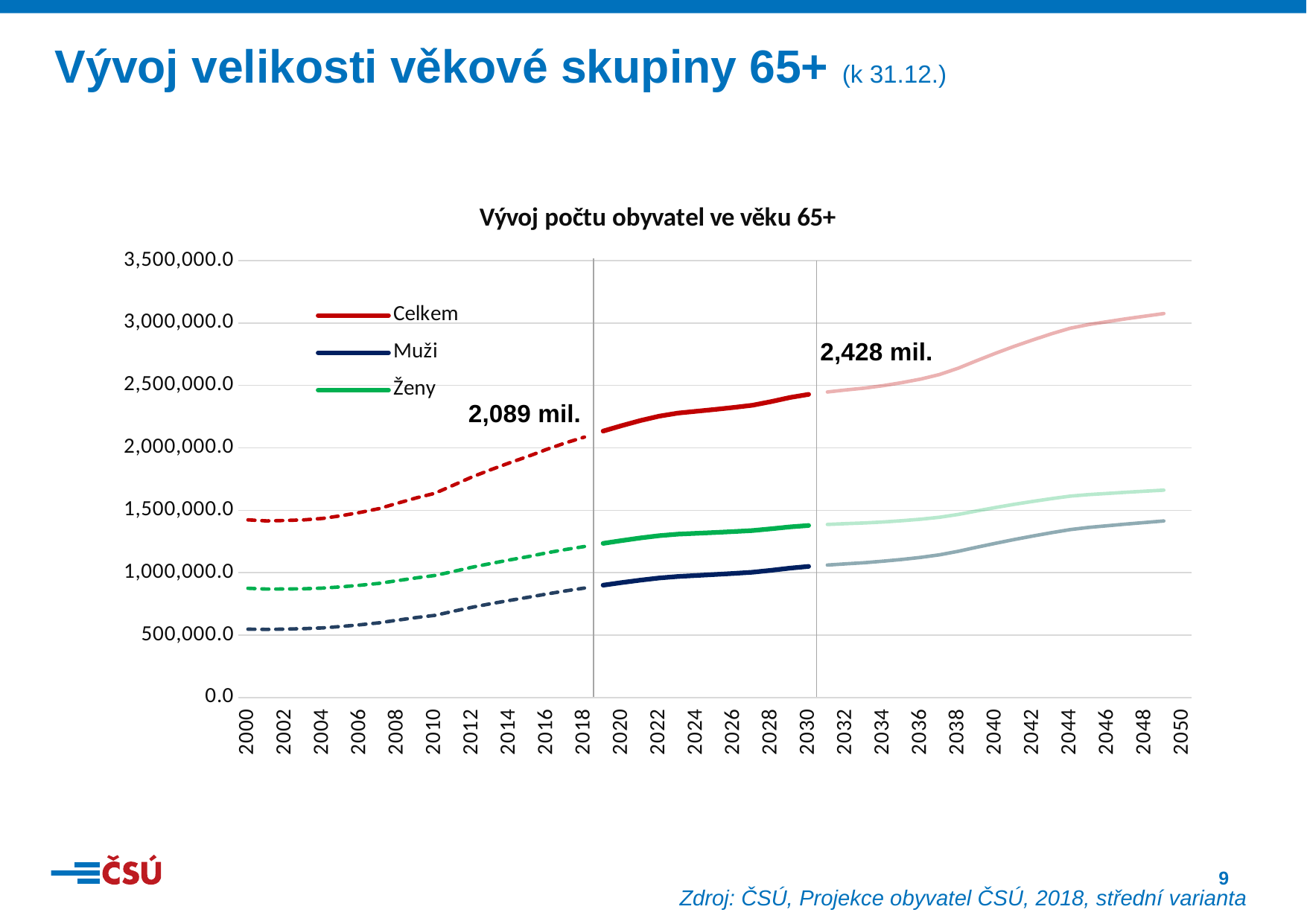
Which series has the highest values throughout the chart? Celkem What value is labelled for Celkem in 2018? 2,089 mil. Is the value for Ženy in 2000 greater or less than 1,000,000.0? less How many series does the legend list? 3 Is the value for Celkem in 2000 greater or less than 1,500,000.0? less What are the series listed in the legend? Celkem, Muži, Ženy What value is labelled for Celkem in 2030? 2,428 mil. What kind of chart is shown on the slide? line chart What is the difference between the labelled Celkem values for 2030 and 2018? 0,339 mil. What is the title of the chart? Vývoj počtu obyvatel ve věku 65+ In 2030, which is larger, the value for Ženy or the value for Muži? Ženy